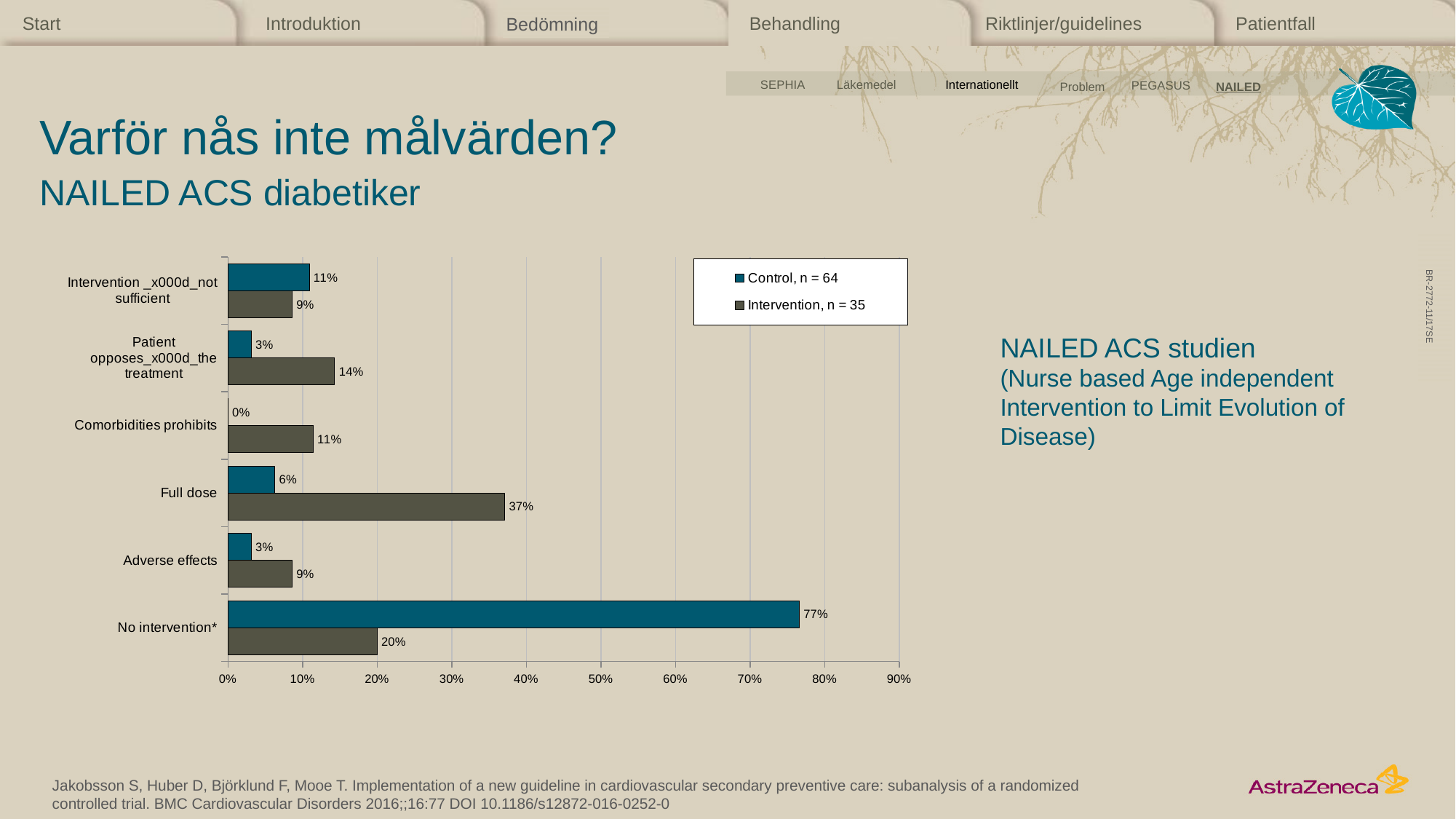
What is the Intervention value for Full dose? 37% What is the difference between the Control and Intervention values for No intervention*? 57% Which category has the highest Intervention value? Full dose How many categories are shown on the chart? 6 Which category has the lowest Control value? Comorbidities prohibits What is the Intervention value for Patient opposes the treatment? 14% What kind of chart is shown on the slide? Bar chart What is the Control value for No intervention*? 77% Which is larger for Full dose, the Control value or the Intervention value? Intervention What is the Control value for Comorbidities prohibits? 0% Which category has the highest Control value? No intervention* How many series does the legend list? 2